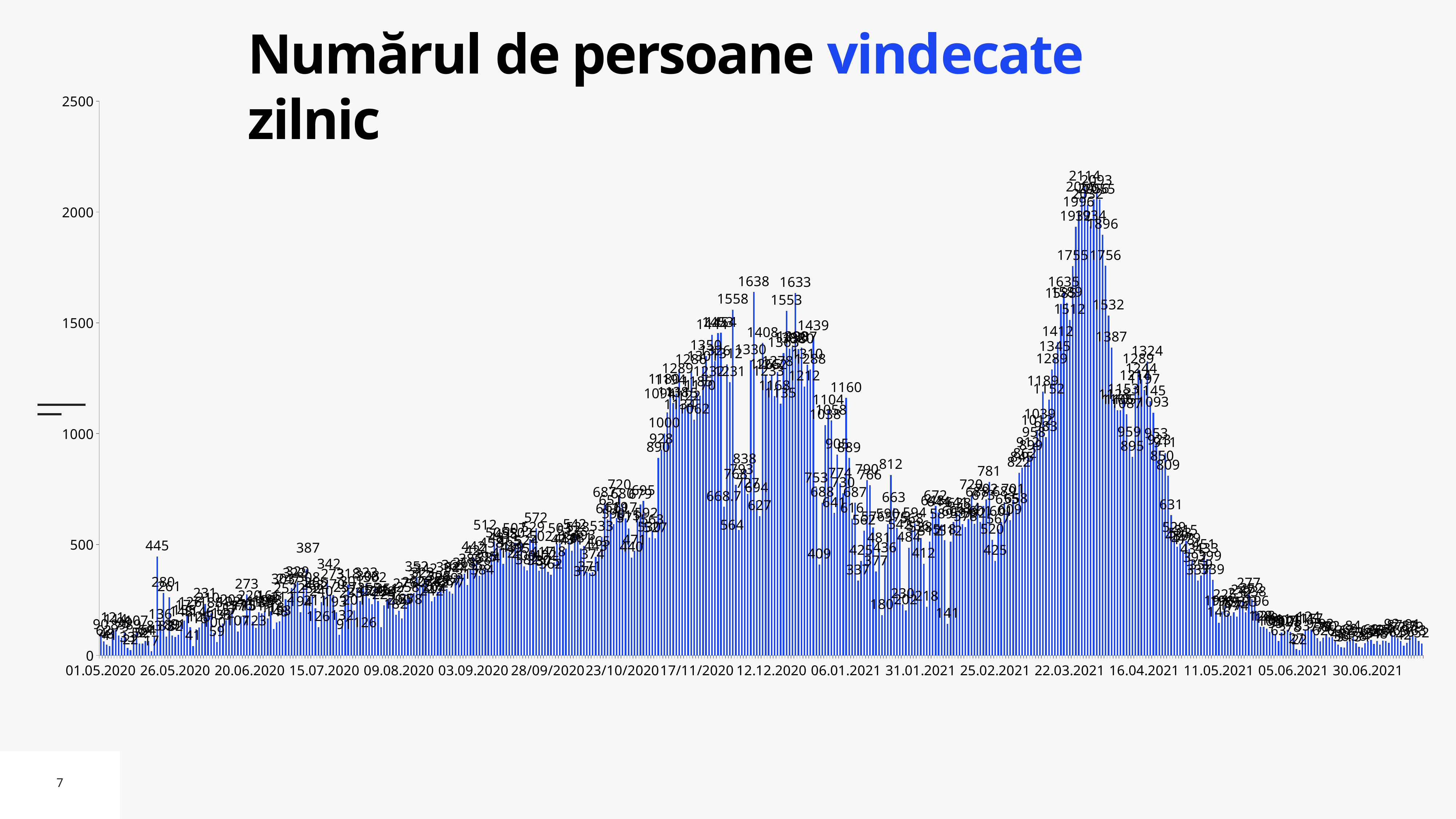
Which is larger: the peak of the November 2020 wave (1638) or the peak of the March 2021 wave (2114)? the March 2021 wave (2114) Do the values generally rise or fall from 01.05.2020 to 03.09.2020? rise What kind of chart is shown on the slide? bar chart What is the value of the tallest bar in May 2020 (the labeled spike just after 26.05.2020)? 445 What is the difference between the peak of the March 2021 wave (2114) and the peak of the November 2020 wave (1638)? 476 Do the values rise or fall from the peak around 22.03.2021 to 30.06.2021? fall What is the highest data label shown on the chart? 2114 What is the title of the chart on the slide? Numărul de persoane vindecate zilnic Are the bars around 30.06.2021 greater or less than 500? less Which word in the chart title is written in blue? vindecate What is the value of the tallest bar in the November–December 2020 wave (the highest label between 17/11/2020 and 12.12.2020)? 1638 Is the tallest bar on the chart greater or less than 2000? greater